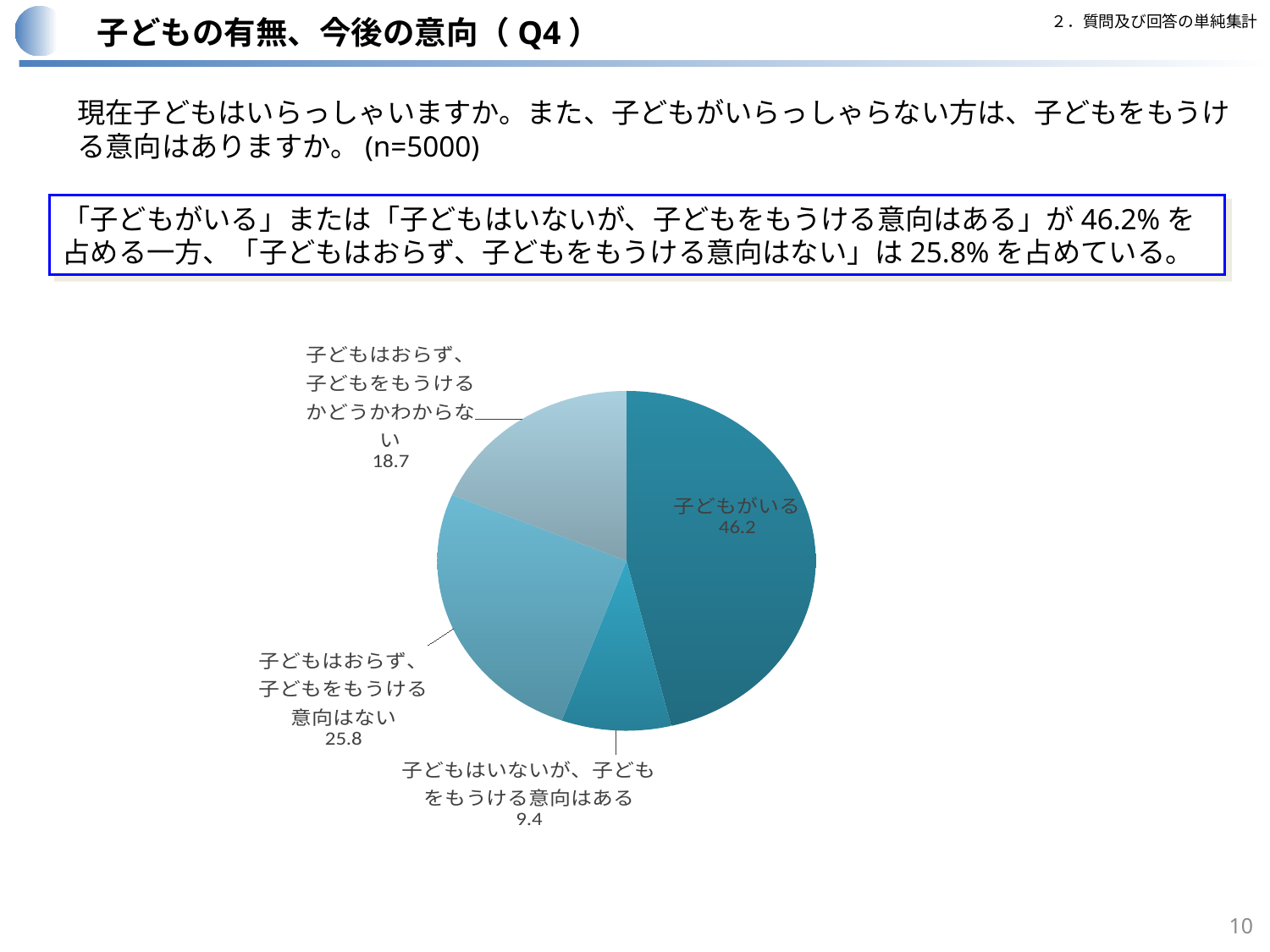
What is the value shown for 子どもはおらず、子どもをもうけるかどうかわからない? 18.7 What is the difference between the values for 子どもがいる and 子どもはおらず、子どもをもうける意向はない? 20.4 Which category has the smallest slice of the pie? 子どもはいないが、子どもをもうける意向はある What is the value shown for 子どもがいる? 46.2 How many slices does the pie chart have? 4 Which category has the largest slice of the pie? 子どもがいる What is the sample size (n) stated in the question text above the chart? n=5000 What is the combined value of 子どもがいる and 子どもはいないが、子どもをもうける意向はある? 55.6 What kind of chart is shown on the slide? Pie chart Which is larger: the value for 子どもはおらず、子どもをもうける意向はない or the value for 子どもはおらず、子どもをもうけるかどうかわからない? 子どもはおらず、子どもをもうける意向はない What is the value shown for 子どもはおらず、子どもをもうける意向はない? 25.8 What is the value shown for 子どもはいないが、子どもをもうける意向はある? 9.4